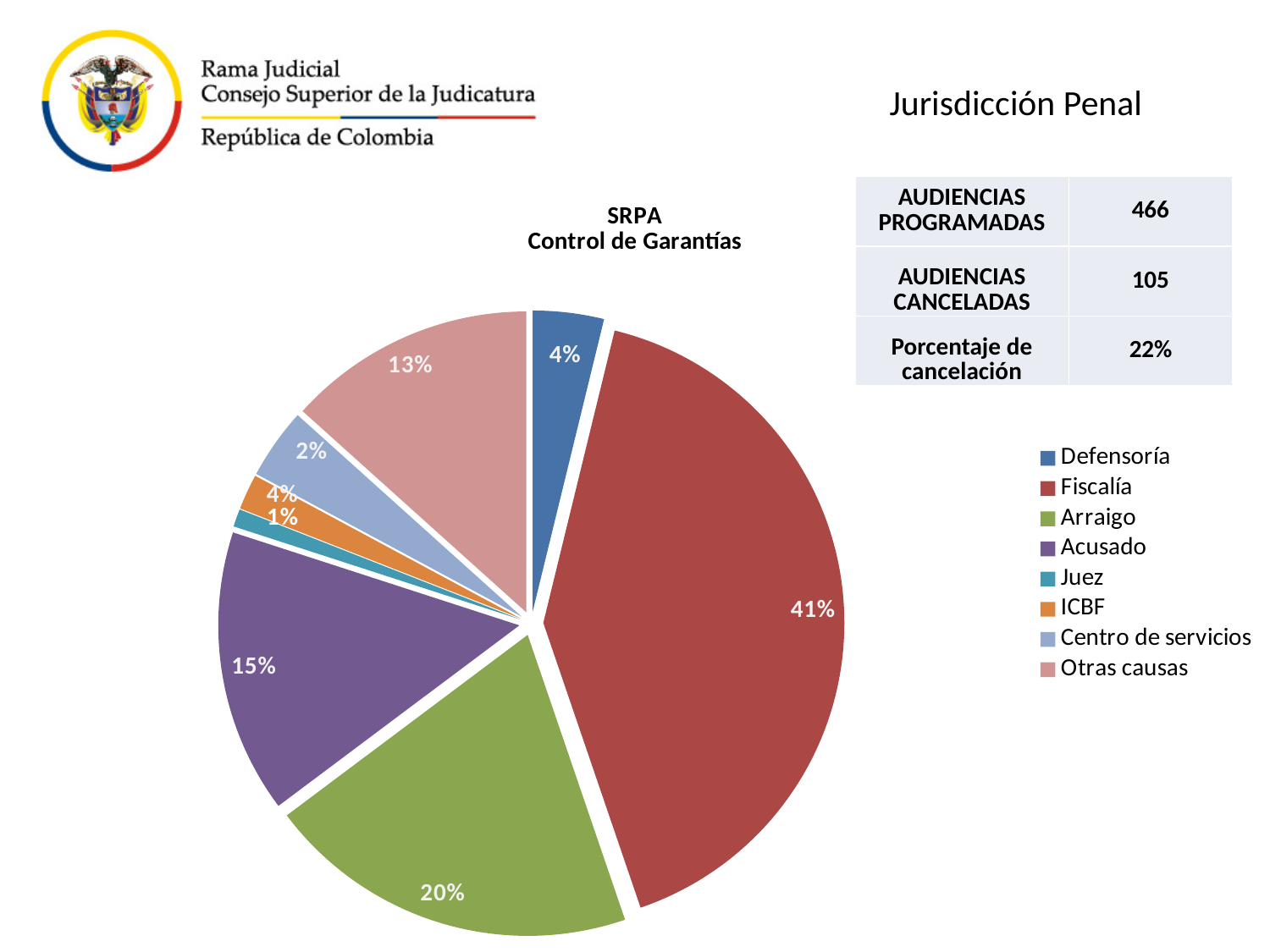
What share of the pie does Fiscalía represent? 41% What share of the pie does Arraigo represent? 20% How many categories does the legend of the pie chart list? 8 What share of the pie does Acusado represent? 15% Which slice is larger, Acusado or Otras causas? Acusado What type of chart is shown on the slide? Pie chart What is the title of the pie chart? SRPA Control de Garantías What is the difference in percentage points between the Fiscalía slice and the Arraigo slice? 21 Which category has the smallest slice of the pie? Juez Which category has the largest slice of the pie? Fiscalía